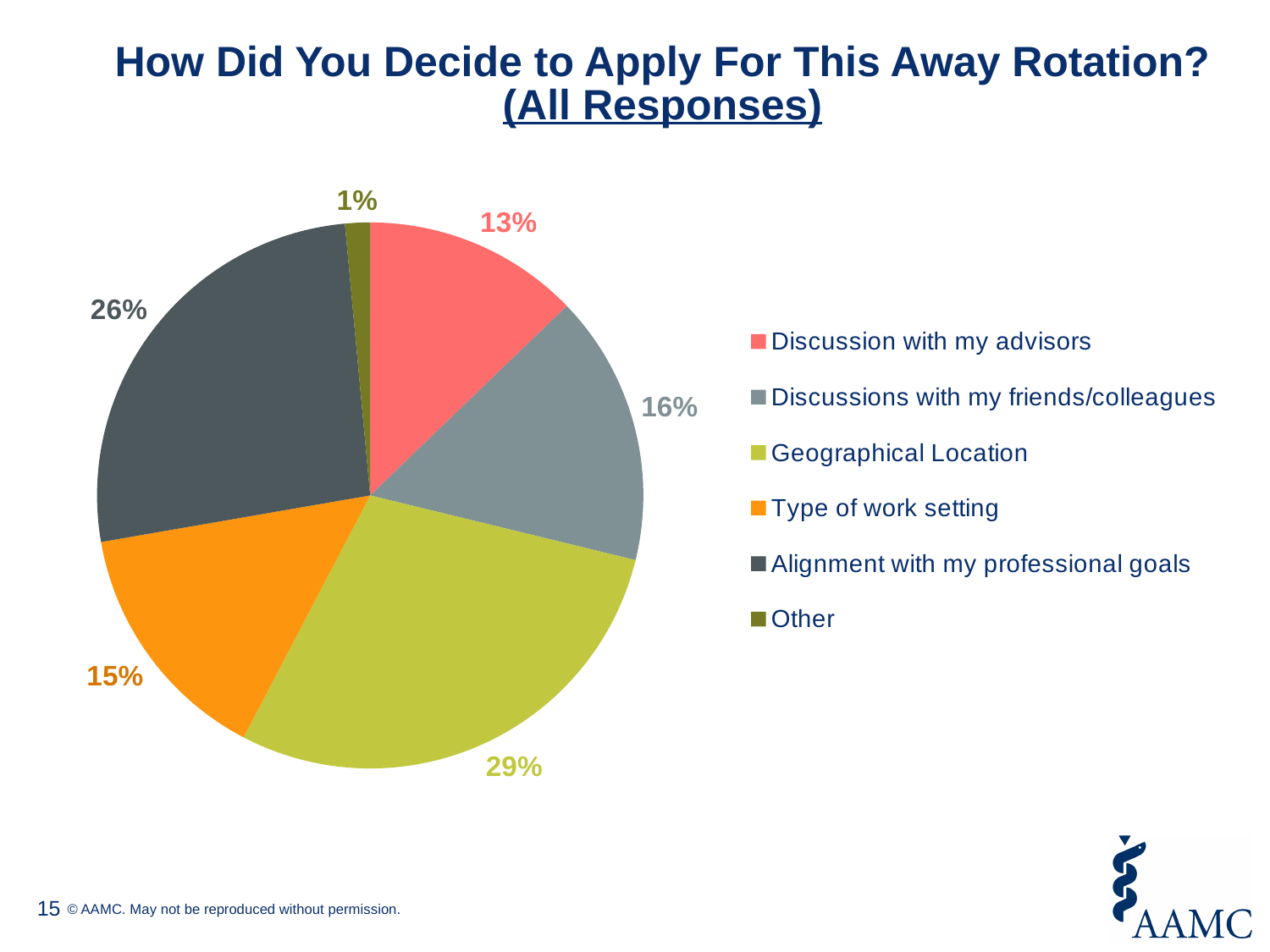
Which category has the largest share of the pie? Geographical Location What share of responses is Alignment with my professional goals? 26% What share of responses is Discussion with my advisors? 13% What share of responses is Type of work setting? 15% What is the title of the chart? How Did You Decide to Apply For This Away Rotation? (All Responses) What is the combined share of Discussion with my advisors and Discussions with my friends/colleagues? 29% How many categories does the pie chart have? 6 What kind of chart is shown on the slide? pie chart Which category has the smallest share of the pie? Other What share of responses is Geographical Location? 29% What is the difference in percentage points between Geographical Location and Alignment with my professional goals? 3 Which is larger, Discussions with my friends/colleagues or Type of work setting? Discussions with my friends/colleagues